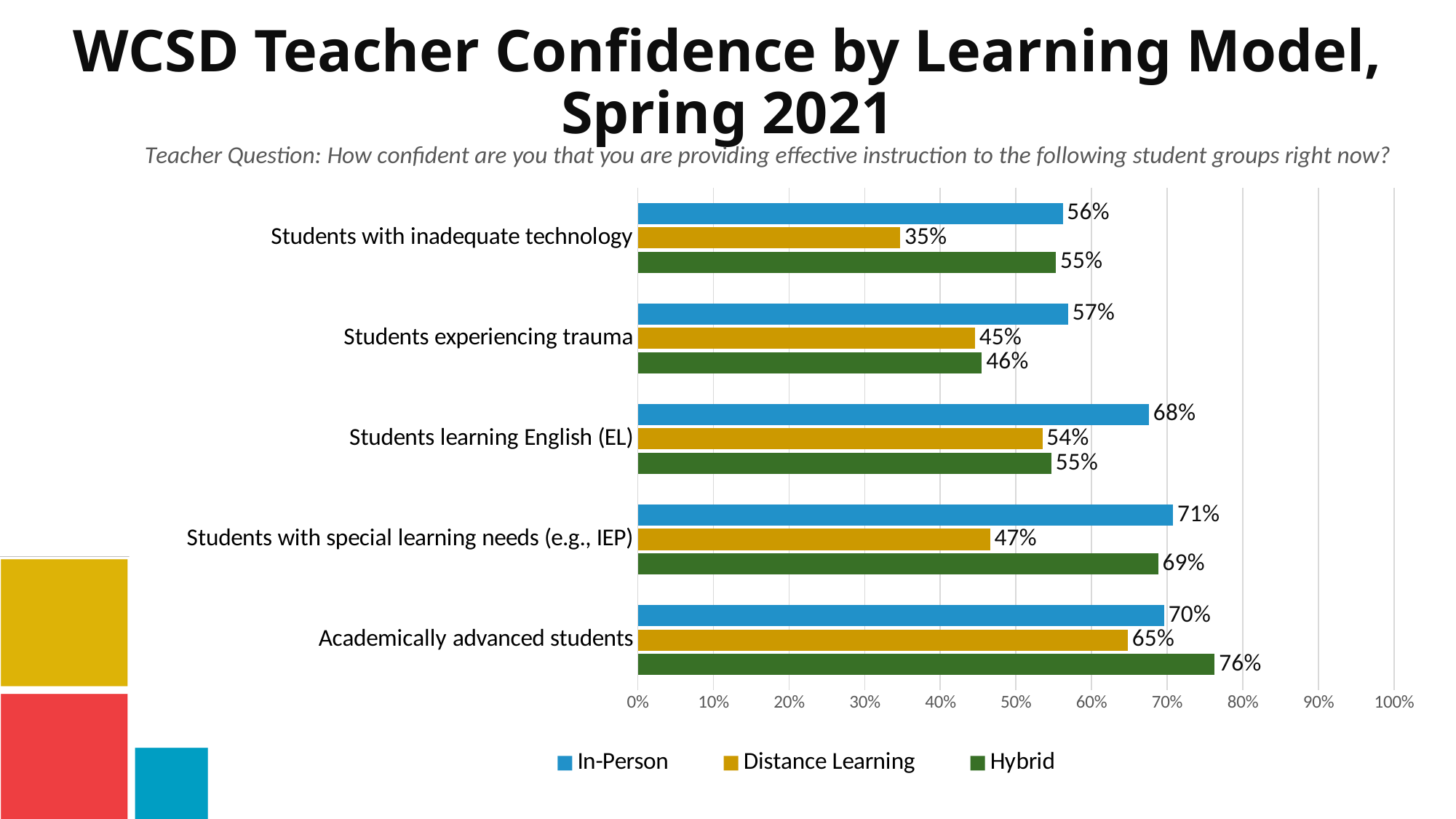
Which colour represents Distance Learning in the legend? Gold What is the Hybrid value for Students with special learning needs (e.g., IEP)? 69% How many student groups are shown on the chart? 5 Which student group has the highest Hybrid value? Academically advanced students What is the difference between the In-Person and Distance Learning values for Students with special learning needs (e.g., IEP)? 24% For Academically advanced students, which is larger: the In-Person value or the Hybrid value? Hybrid What is the Distance Learning value for Academically advanced students? 65% How many series does the legend list? 3 Which student group has the lowest Distance Learning value? Students with inadequate technology What is the In-Person value for Students with inadequate technology? 56% What kind of chart is shown on the slide? bar chart Is the Distance Learning value for Students experiencing trauma greater or less than 50%? less